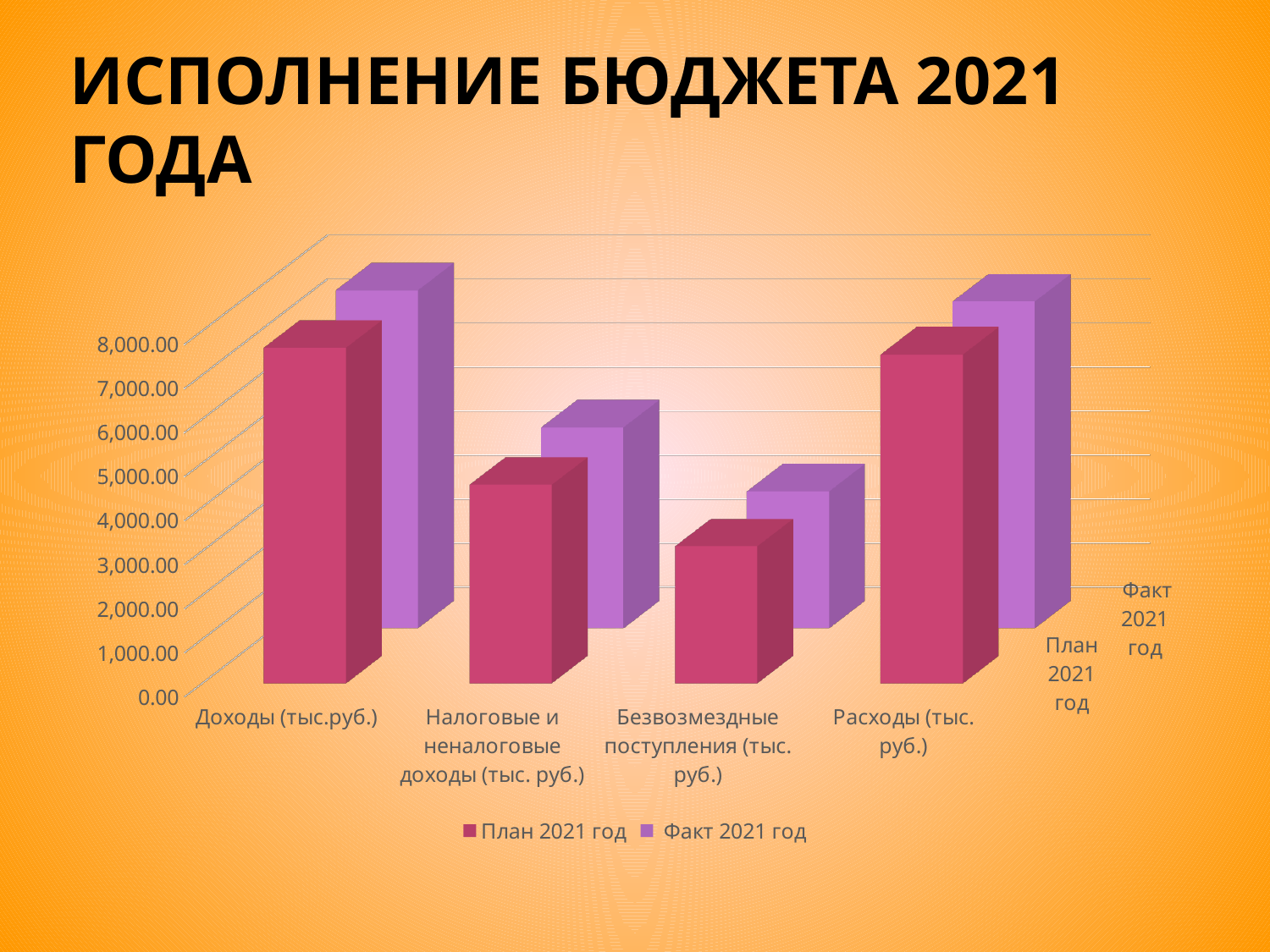
For the Факт 2021 год series, which is larger: Доходы (тыс.руб.) or Безвозмездные поступления (тыс. руб.)? Доходы (тыс.руб.) How many series does the chart legend list? 2 For the План 2021 год series, which is larger: Налоговые и неналоговые доходы (тыс. руб.) or Безвозмездные поступления (тыс. руб.)? Налоговые и неналоговые доходы (тыс. руб.) What kind of chart is shown on the slide? bar chart Is the План 2021 год value for Доходы (тыс.руб.) greater or less than 5,000.00? greater How many categories are shown on the x axis of the chart? 4 Is the План 2021 год value for Налоговые и неналоговые доходы (тыс. руб.) greater or less than 6,000.00? less What is the title of the slide containing the chart? ИСПОЛНЕНИЕ БЮДЖЕТА 2021 ГОДА Is the План 2021 год value for Безвозмездные поступления (тыс. руб.) greater or less than 5,000.00? less Which category has the lowest value for the План 2021 год series? Безвозмездные поступления (тыс. руб.) What are the two series listed in the chart legend? План 2021 год and Факт 2021 год